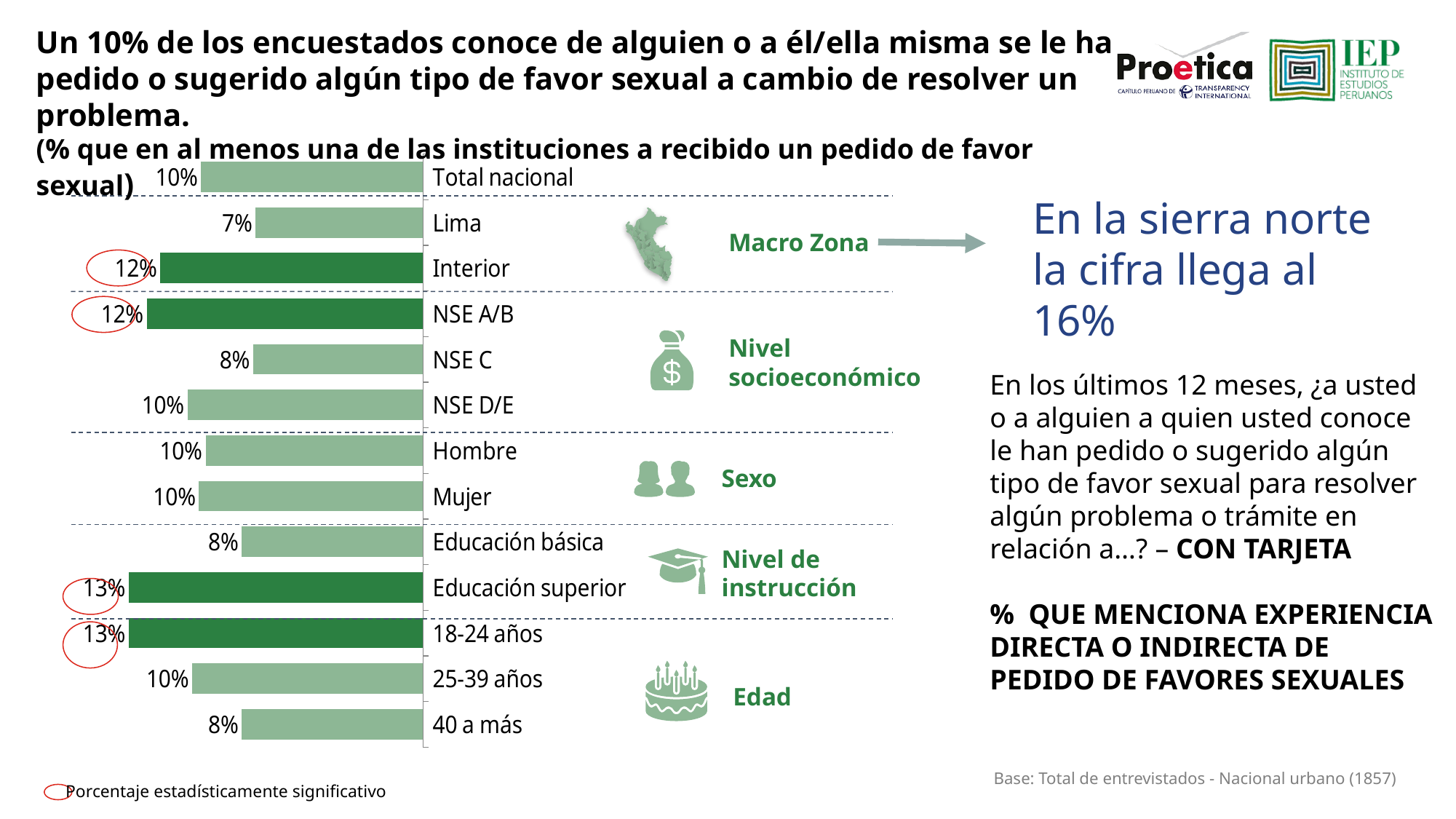
What is the difference between the values for Educación superior and Educación básica? 5% What is the difference between the values for Interior and Lima? 5% What kind of chart is shown on the slide? Bar chart What is the value for Educación superior? 13% What is the value for Lima? 7% Which is larger, the value for 18-24 años or the value for 25-39 años? 18-24 años What is the value for NSE C? 8% Which category has the lowest value? Lima How many categories are shown in the chart? 13 Which is larger, the value for NSE A/B or the value for NSE C? NSE A/B What is the value for 40 a más? 8% What is the value for Interior? 12%